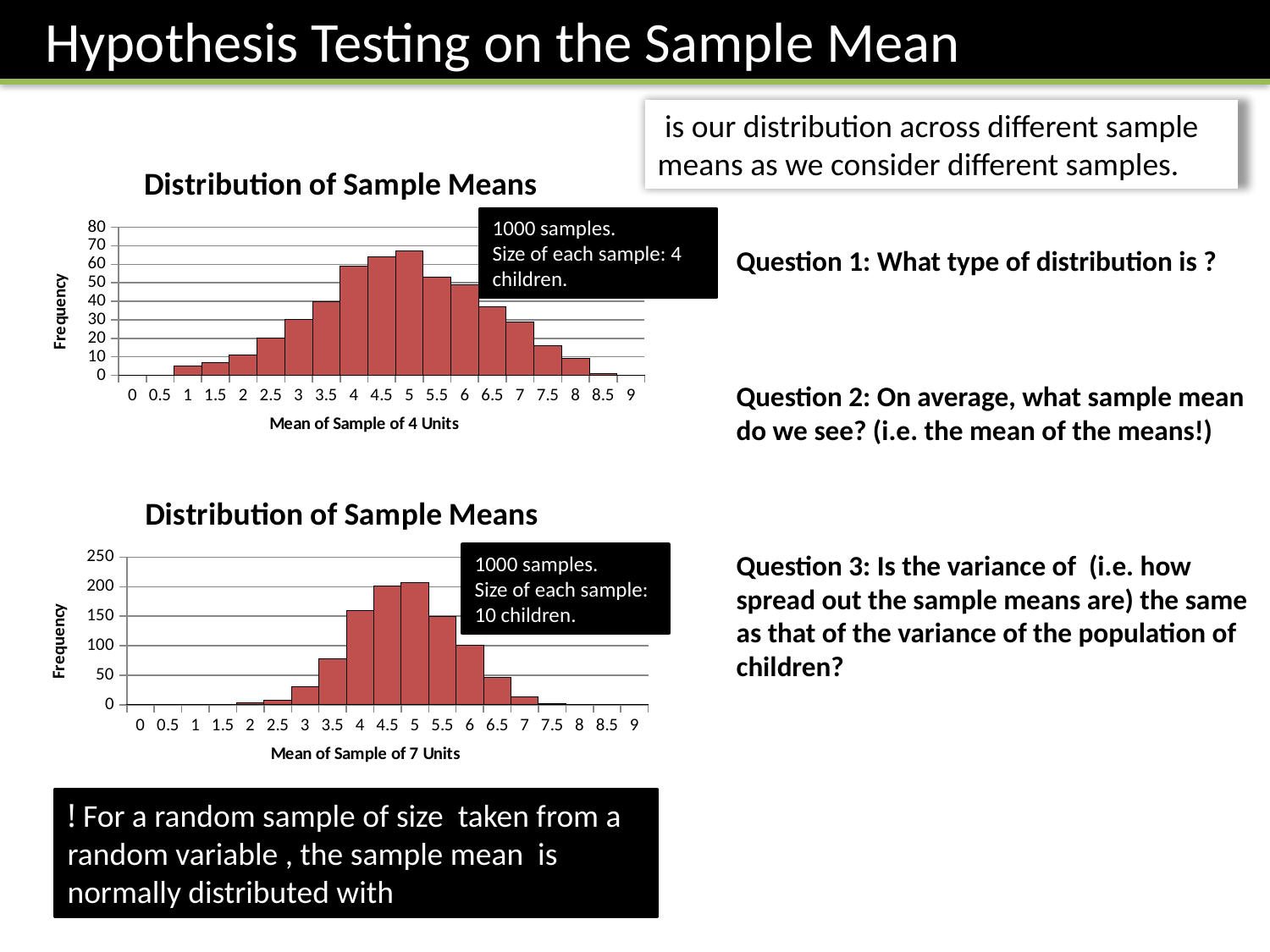
In the top chart (Mean of Sample of 4 Units), do the frequencies rise or fall as the mean goes from 1 to 4? rise In the bottom chart (Mean of Sample of 7 Units), is the frequency for the bar at 7 greater or less than 50? less What is the title of the bottom chart, whose x axis is labelled 'Mean of Sample of 7 Units'? Distribution of Sample Means In the bottom chart (Mean of Sample of 7 Units), is the frequency for the bar at 4 greater or less than 150? greater In the bottom chart (Mean of Sample of 7 Units), is the frequency for the bar at 3.5 greater or less than 100? less In the top chart (Mean of Sample of 4 Units), which bar has the higher frequency, the one at 3 or the one at 4? 4 In the bottom chart (Mean of Sample of 7 Units), which bar has the higher frequency, the one at 5.5 or the one at 6? 5.5 What is the y-axis label of the top chart (Mean of Sample of 4 Units)? Frequency What type of chart is the top chart, whose x axis is labelled 'Mean of Sample of 4 Units'? bar chart